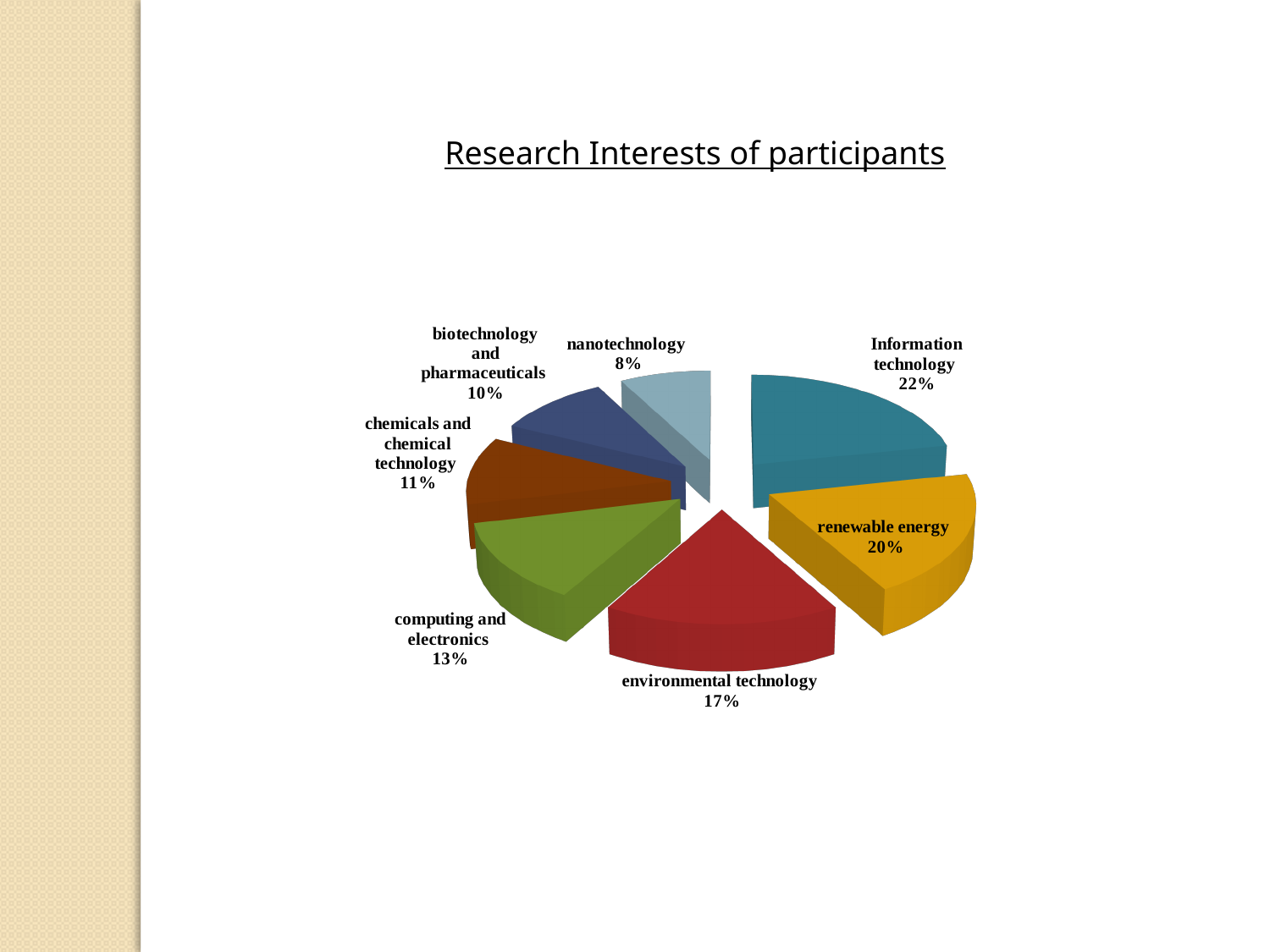
What percentage is shown for environmental technology? 17% How many slices does the pie chart have? 7 Which research interest has the smallest share of the pie? nanotechnology What kind of chart is shown on the slide? pie chart What percentage is shown for chemicals and chemical technology? 11% What share of participants have Information technology as a research interest? 22% What percentage is shown for renewable energy? 20% What percentage is shown for computing and electronics? 13% What is the title of the chart? Research Interests of participants Which research interest has the largest share of the pie? Information technology Which is larger, the share for renewable energy or the share for environmental technology? renewable energy What is the difference in percentage points between Information technology and nanotechnology? 14